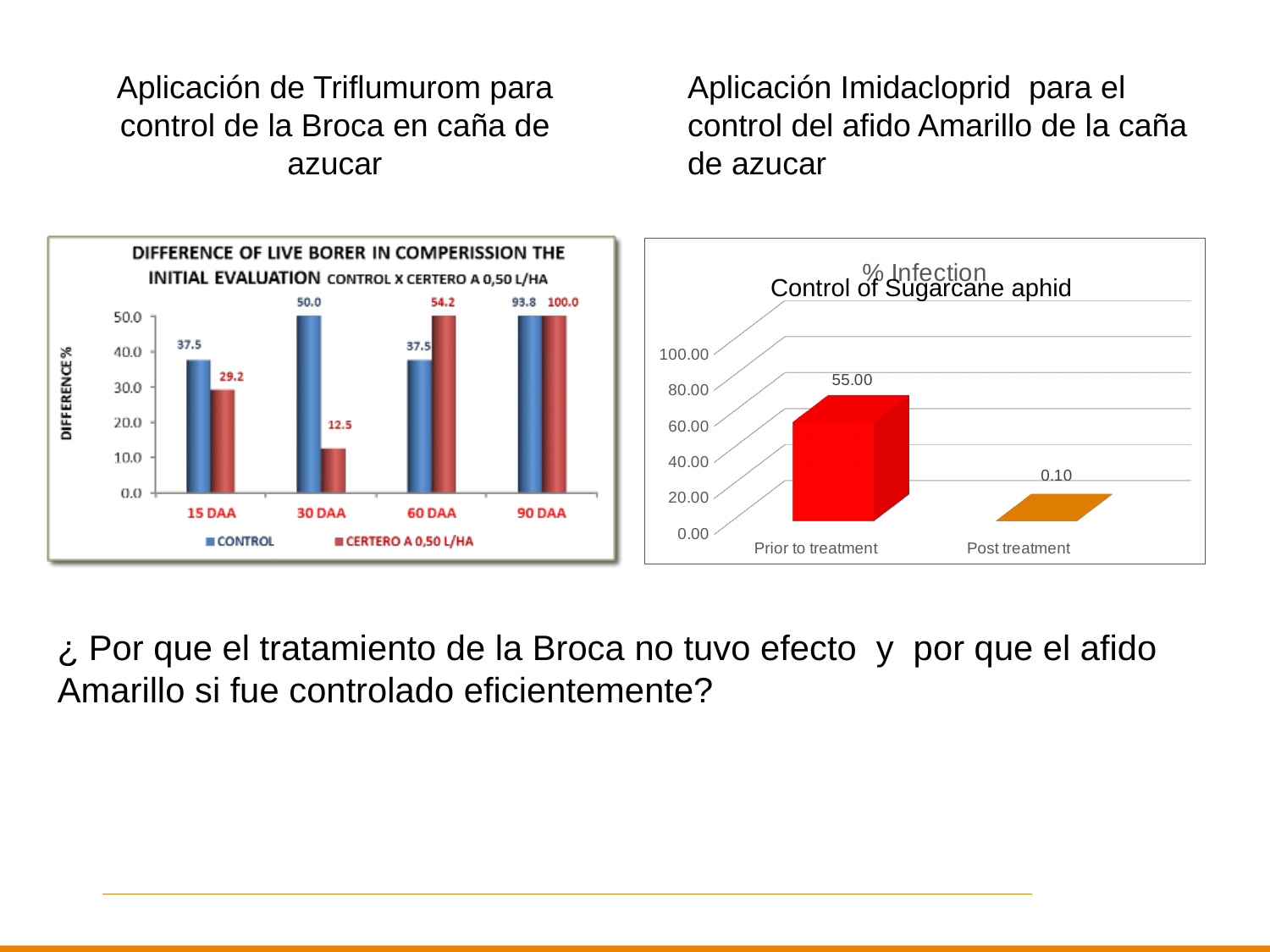
In the left chart (Difference of Live Borer), how many DAA categories are shown on the x axis? 4 In the left chart (Difference of Live Borer), what is the difference between the CONTROL and CERTERO A 0,50 L/HA values at 30 DAA? 37.5 In the left chart (Difference of Live Borer), what is the CERTERO A 0,50 L/HA value at 90 DAA? 100.0 In the left chart (Difference of Live Borer), which series has the larger value at 60 DAA, CONTROL or CERTERO A 0,50 L/HA? CERTERO A 0,50 L/HA In the left chart (Difference of Live Borer), what is the CONTROL value at 30 DAA? 50.0 In the left chart (Difference of Live Borer), what is the CERTERO A 0,50 L/HA value at 15 DAA? 29.2 What kind of chart is the right chart (Control of Sugarcane aphid)? Bar chart In the left chart (Difference of Live Borer), at which DAA category is the CONTROL value highest? 90 DAA In the left chart (Difference of Live Borer), at which DAA category is the CERTERO A 0,50 L/HA value lowest? 30 DAA In the right chart (Control of Sugarcane aphid), what is the % Infection value post treatment? 0.10 In the left chart (Difference of Live Borer), how many series does the legend list? 2 In the right chart (Control of Sugarcane aphid), what is the % Infection value prior to treatment? 55.00